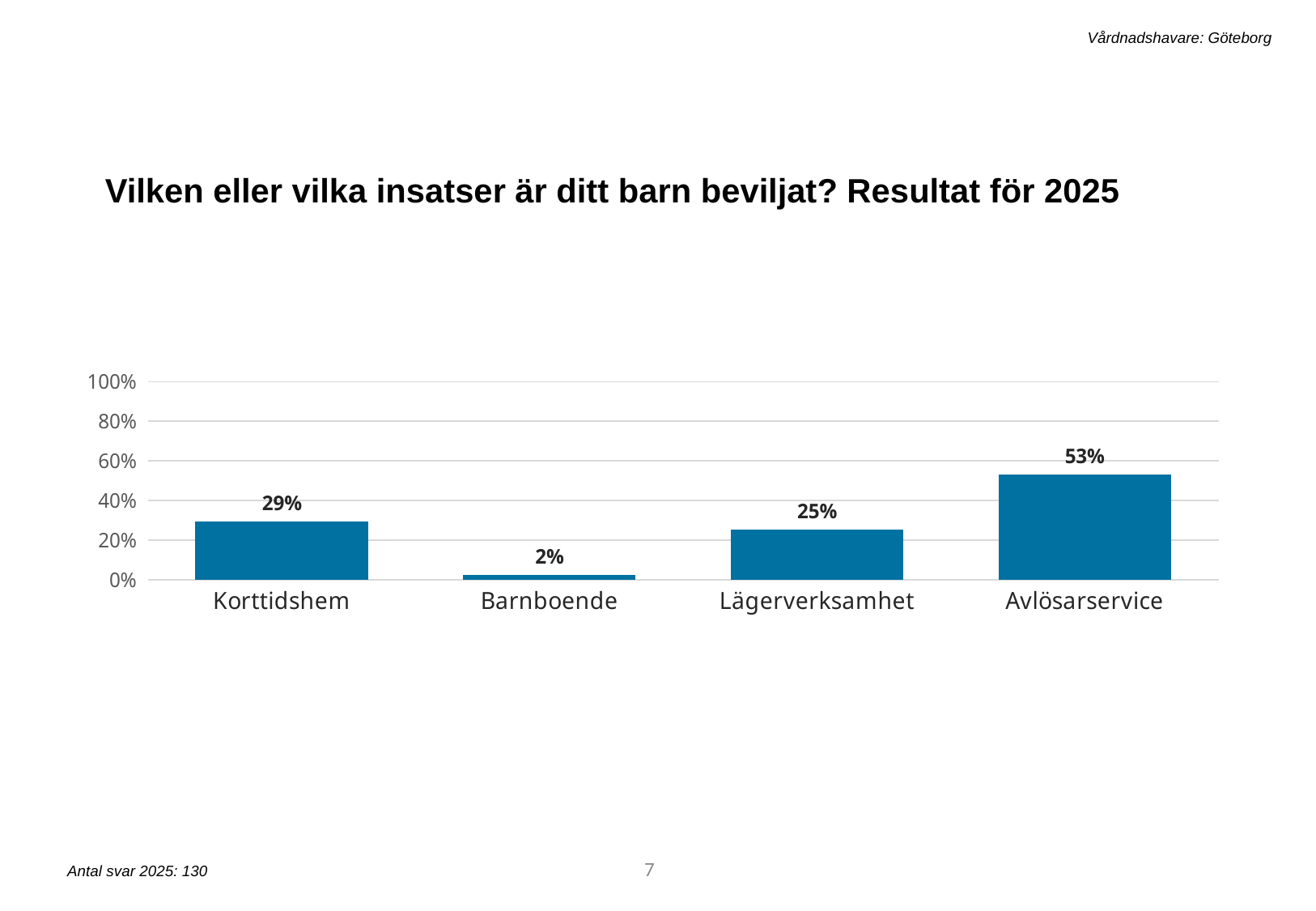
Which category has the highest value? Avlösarservice What kind of chart is shown on the slide? bar chart Which is larger, the value for Korttidshem or the value for Lägerverksamhet? Korttidshem What is the title of the chart? Vilken eller vilka insatser är ditt barn beviljat? Resultat för 2025 What is the value for Barnboende? 2% What is the difference between the values for Avlösarservice and Korttidshem? 24% How many categories are shown on the x axis? 4 What is the value for Korttidshem? 29% Which category has the lowest value? Barnboende What is the value for Lägerverksamhet? 25% What is the value for Avlösarservice? 53% Is the value for Avlösarservice greater or less than 40%? greater